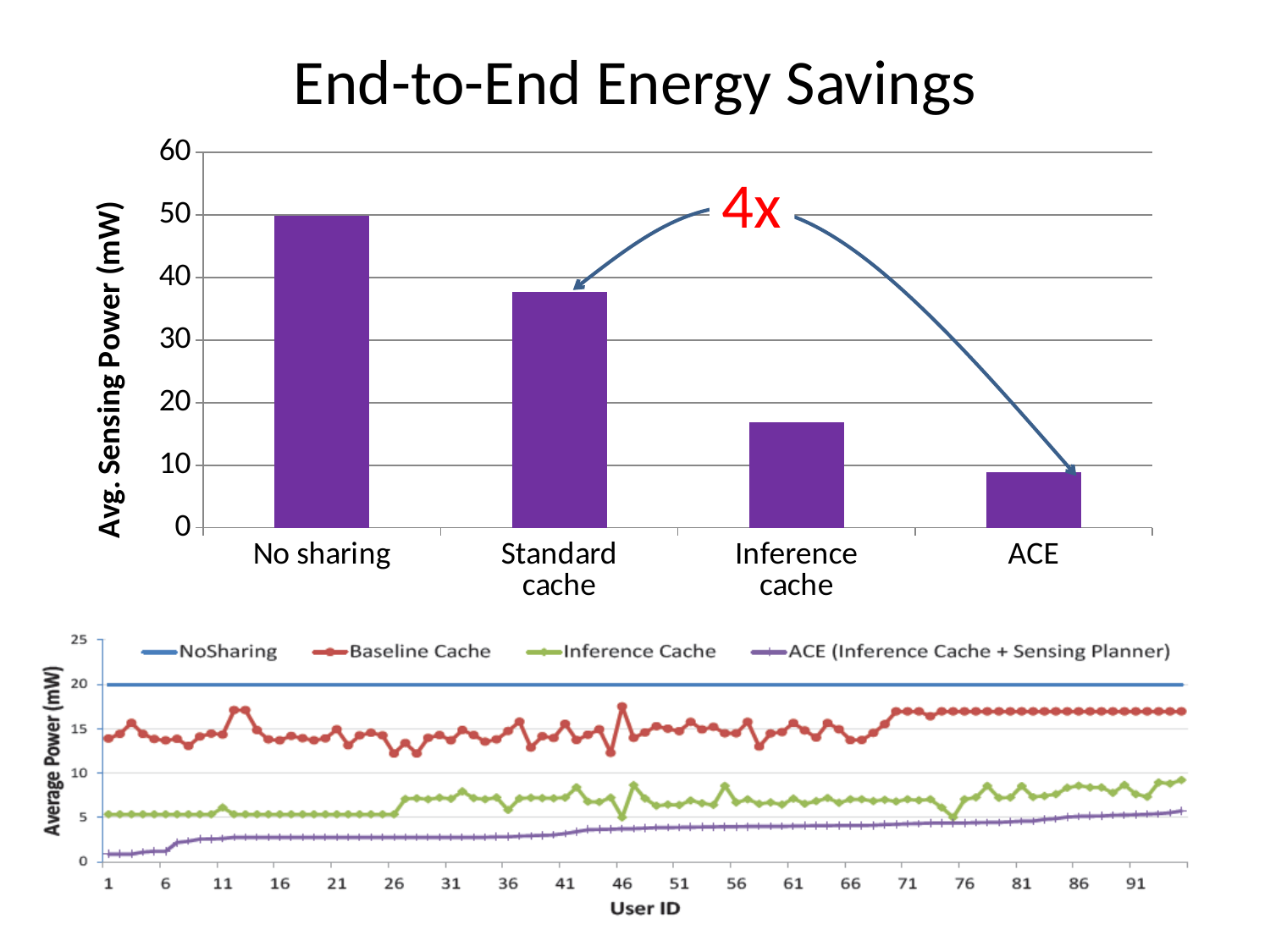
In the top bar chart, how many categories are shown on the x axis? 4 In the bottom line chart, which series has the highest average power across all user IDs? NoSharing In the bottom line chart, how many series does the legend list? 4 In the bottom line chart, does the ACE (Inference Cache + Sensing Planner) series rise or fall as User ID increases? rise What kind of chart is the top chart on the slide? bar chart In the top bar chart, what is the label of the y axis? Avg. Sensing Power (mW) In the top bar chart, is the value for Inference cache greater or less than 20? less In the top bar chart, which category has the highest average sensing power? No sharing In the top bar chart, which is larger, the value for Standard cache or the value for Inference cache? Standard cache In the top bar chart, is the value for ACE greater or less than 10? less In the top bar chart, which category has the lowest average sensing power? ACE In the top bar chart, is the value for Standard cache greater or less than 30? greater